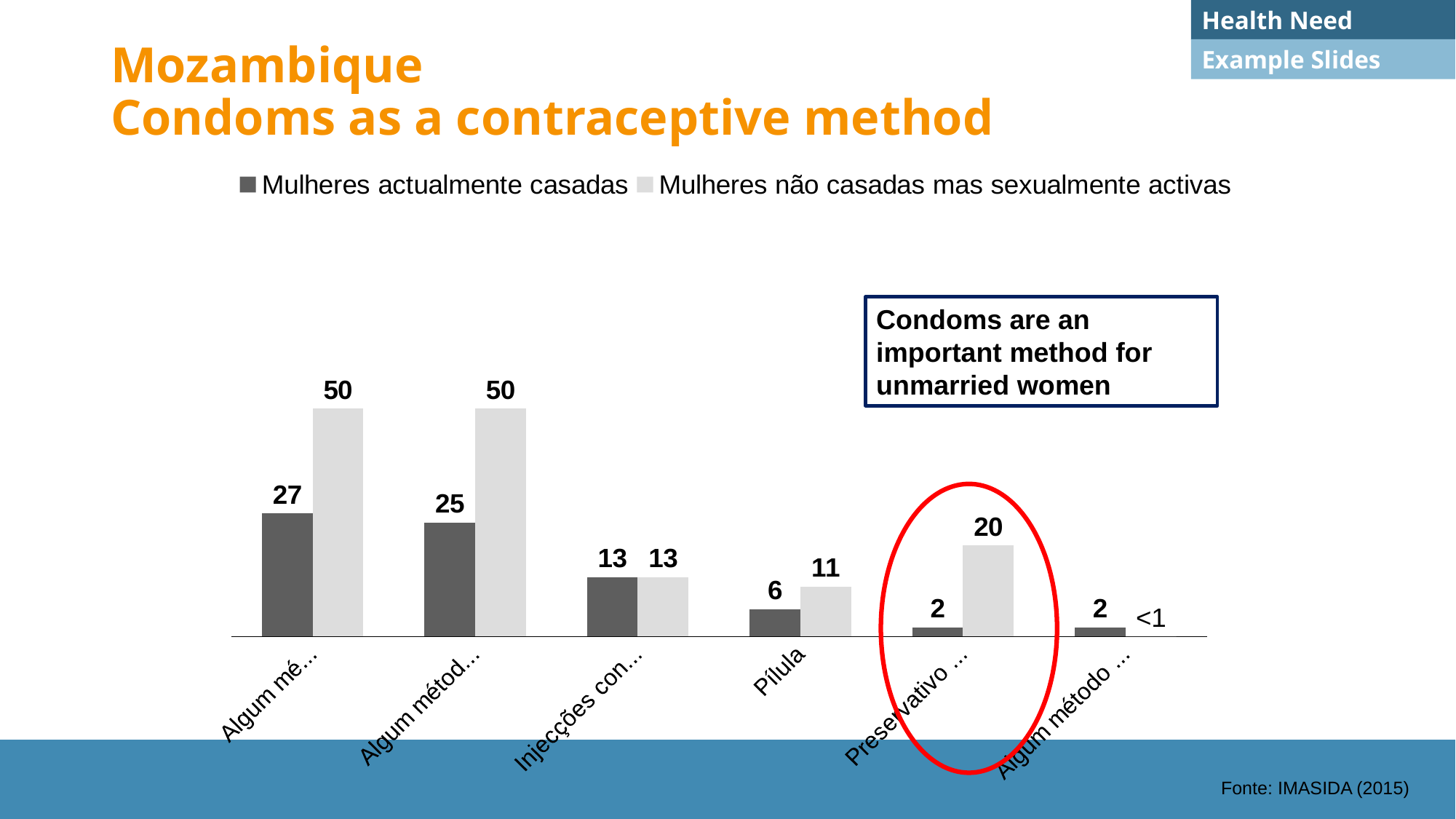
How many categories are shown on the x axis? 6 For Pílula, which series has the larger value? Mulheres não casadas mas sexualmente activas What is the value for Pílula for the series Mulheres actualmente casadas? 6 For the Preservativo category, what is the difference between the value for Mulheres não casadas mas sexualmente activas and the value for Mulheres actualmente casadas? 18 For Pílula, what is the difference between the value for Mulheres não casadas mas sexualmente activas and the value for Mulheres actualmente casadas? 5 For the series Mulheres não casadas mas sexualmente activas, which is larger: the value for Pílula or the value for Preservativo? Preservativo What is the value for the Preservativo category for the series Mulheres actualmente casadas? 2 What kind of chart is shown on the slide? Bar chart What source is cited for the chart data? IMASIDA (2015) How many series does the legend list? 2 What is the value for Pílula for the series Mulheres não casadas mas sexualmente activas? 11 What is the value for the Preservativo category for the series Mulheres não casadas mas sexualmente activas? 20